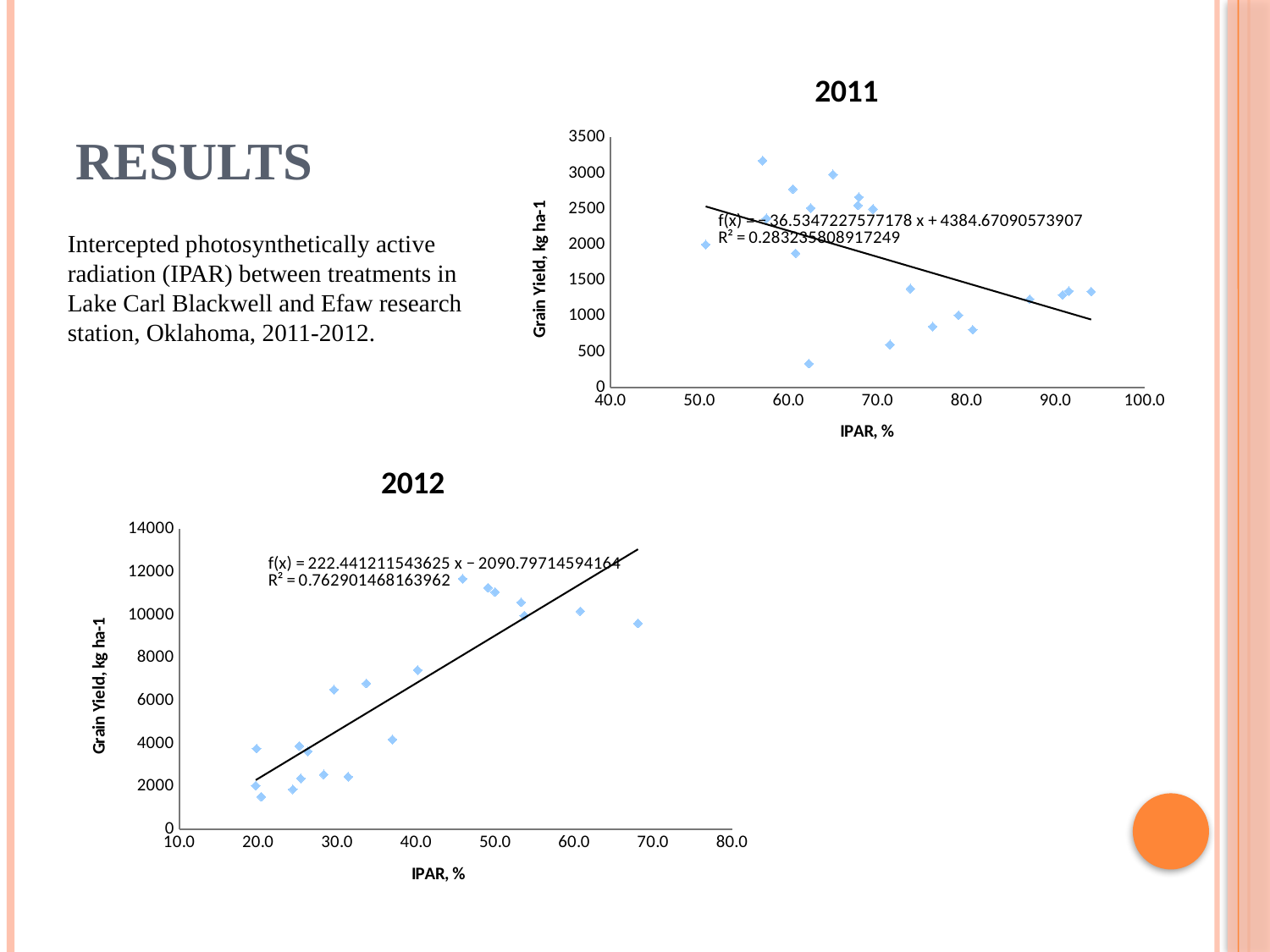
What R² value is printed on the 2011 chart? 0.283235808917249 What kind of chart is the 2011 chart? scatter chart What is the slope of the trendline equation printed on the 2012 chart? 222.441211543625 What is the title of the lower chart on the slide? 2012 In the 2012 chart, is the highest grain yield point greater or less than 10000? greater Which chart shows the higher R² value, 2011 or 2012? 2012 In the 2012 chart, does the fitted trendline rise or fall as IPAR increases? rise What is the x-axis label on the 2012 chart? IPAR, % In the 2011 chart, does the fitted trendline rise or fall as IPAR increases? fall In the 2011 chart, is the lowest grain yield point greater or less than 500? less What is the maximum value shown on the y-axis of the 2012 chart? 14000 What R² value is printed on the 2012 chart? 0.762901468163962